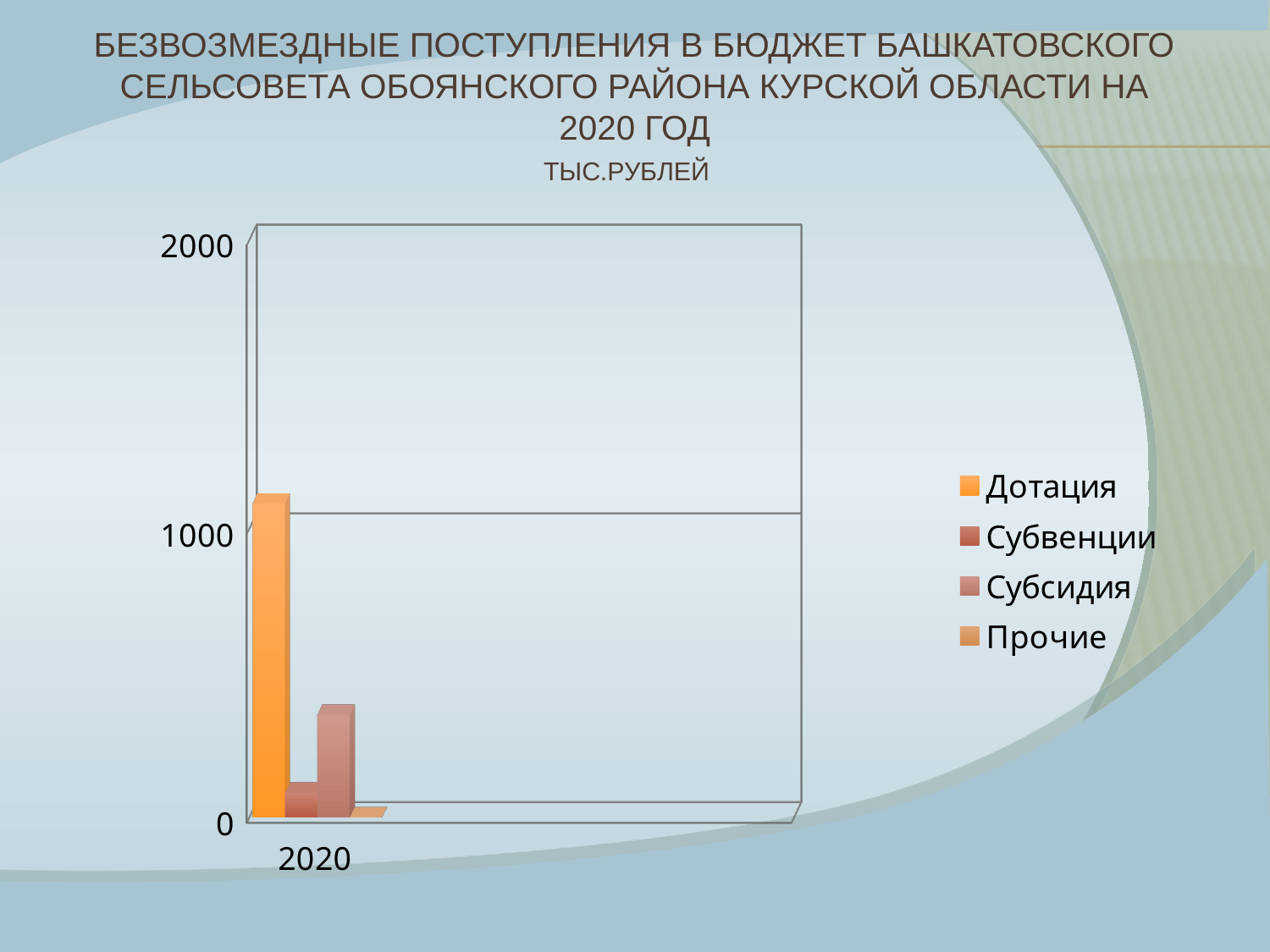
In what units are the values on the chart given, according to the subtitle? ТЫС.РУБЛЕЙ Is the value for Дотация in 2020 greater or less than 2000? less Which series has the lowest value for 2020? Прочие How many series does the legend list? 4 What kind of chart is shown on the slide? bar chart Which is larger for 2020, Дотация or Субсидия? Дотация Is the value for Дотация in 2020 greater or less than 1000? greater Which series has the highest value for 2020? Дотация How many categories are shown on the x axis? 1 Is the value for Субсидия in 2020 greater or less than 1000? less Which is larger for 2020, Субсидия or Субвенции? Субсидия What category label is shown on the x axis? 2020